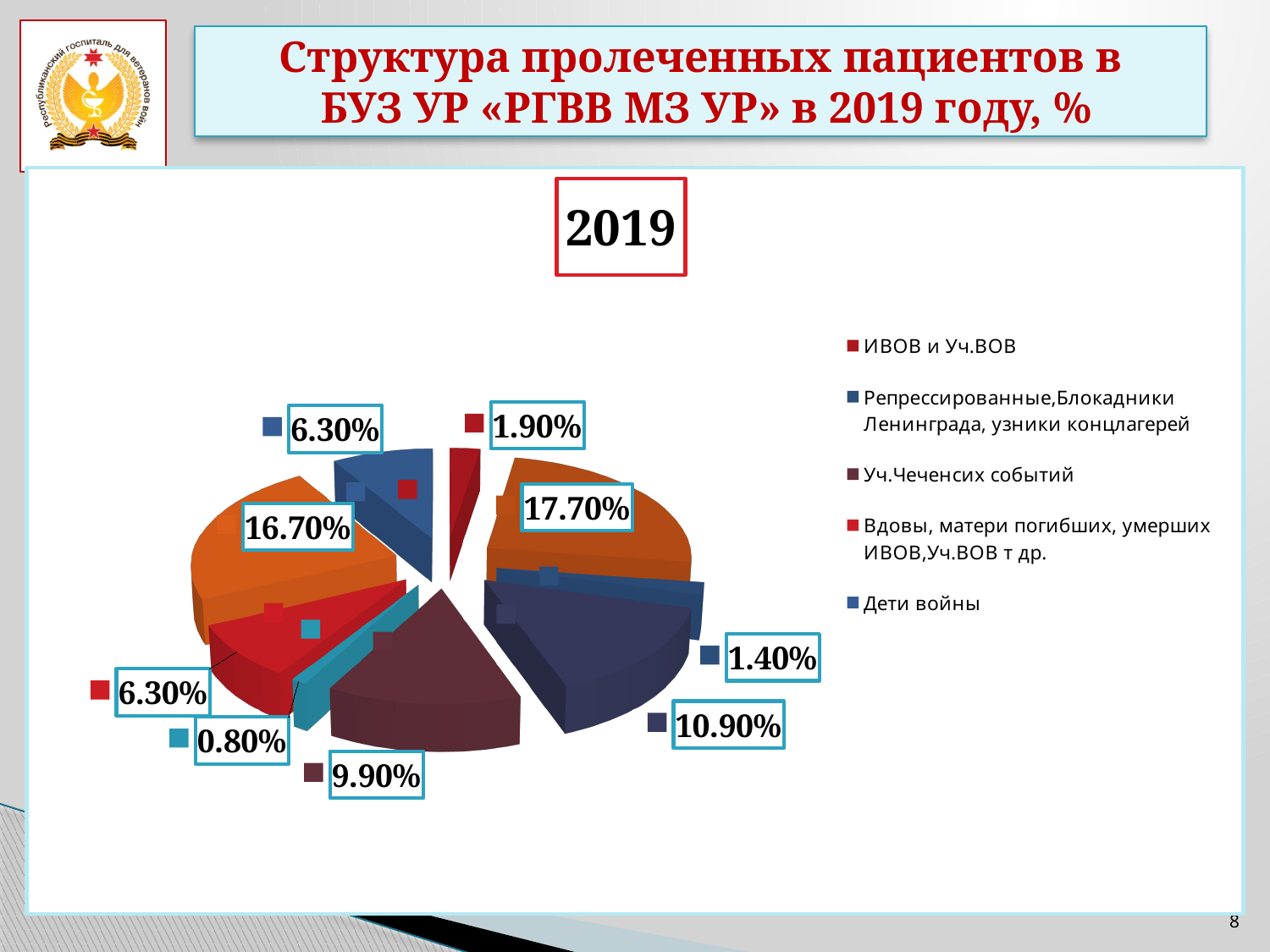
What is the largest value labelled on the pie chart? 17.70% Is the largest labelled value on the pie chart greater or less than 15%? greater What is the smallest value labelled on the pie chart? 0.80% Is the value labelled 1.40% on the pie chart greater or less than 5%? less Which year does the pie chart on the slide refer to? 2019 What share of the pie chart is labelled for the category 'Уч.Чеченсих событий'? 9.90% What kind of chart is shown on the slide? pie chart How many entries does the legend of the pie chart list? 5 Which labelled value is larger on the pie chart: 10.90% or 9.90%? 10.90% What is the difference between the two largest labelled values on the pie chart, 17.70% and 16.70%? 1.00% What is the title of the slide containing the pie chart? Структура пролеченных пациентов в БУЗ УР «РГВВ МЗ УР» в 2019 году, % How many percentage data labels are shown on the pie chart? 9